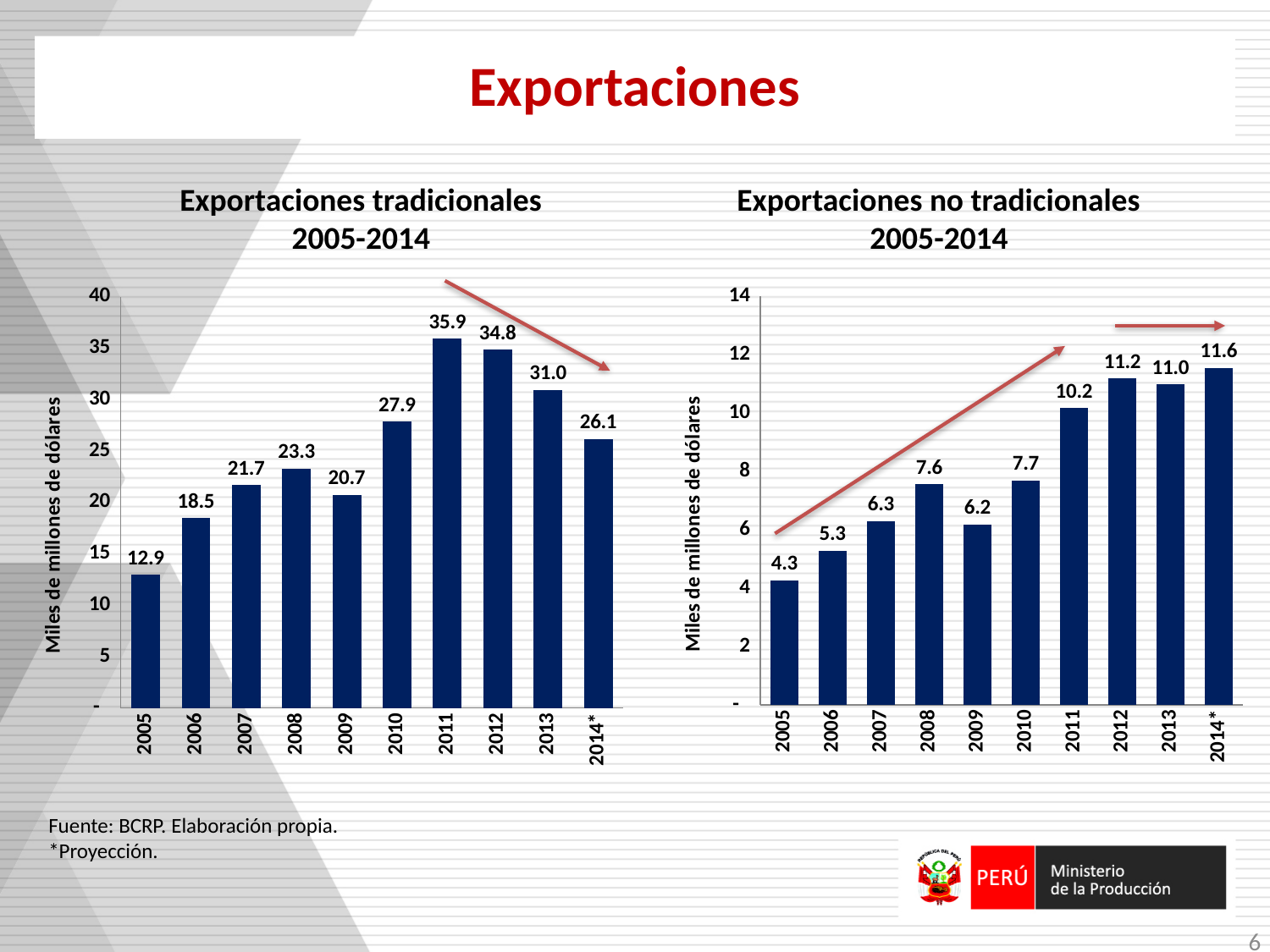
In the 'Exportaciones tradicionales 2005-2014' chart, do the values rise or fall from 2011 to 2014*? fall In the 'Exportaciones tradicionales 2005-2014' chart, which is larger, the value for 2008 or the value for 2009? 2008 In the 'Exportaciones tradicionales 2005-2014' chart, which year has the highest value? 2011 What is the y-axis label of the 'Exportaciones no tradicionales 2005-2014' chart? Miles de millones de dólares How many years are shown on the x axis of the 'Exportaciones tradicionales 2005-2014' chart? 10 In the 'Exportaciones no tradicionales 2005-2014' chart, what is the difference between the values for 2014* and 2005? 7.3 What kind of chart is the 'Exportaciones no tradicionales 2005-2014' chart? bar chart In the 'Exportaciones no tradicionales 2005-2014' chart, what is the value for 2009? 6.2 In the 'Exportaciones no tradicionales 2005-2014' chart, which year has the lowest value? 2005 In the 'Exportaciones tradicionales 2005-2014' chart, what is the difference between the values for 2011 and 2014*? 9.8 In the 'Exportaciones no tradicionales 2005-2014' chart, is the value for 2011 greater or less than 10? greater In the 'Exportaciones tradicionales 2005-2014' chart, what is the value for 2011? 35.9